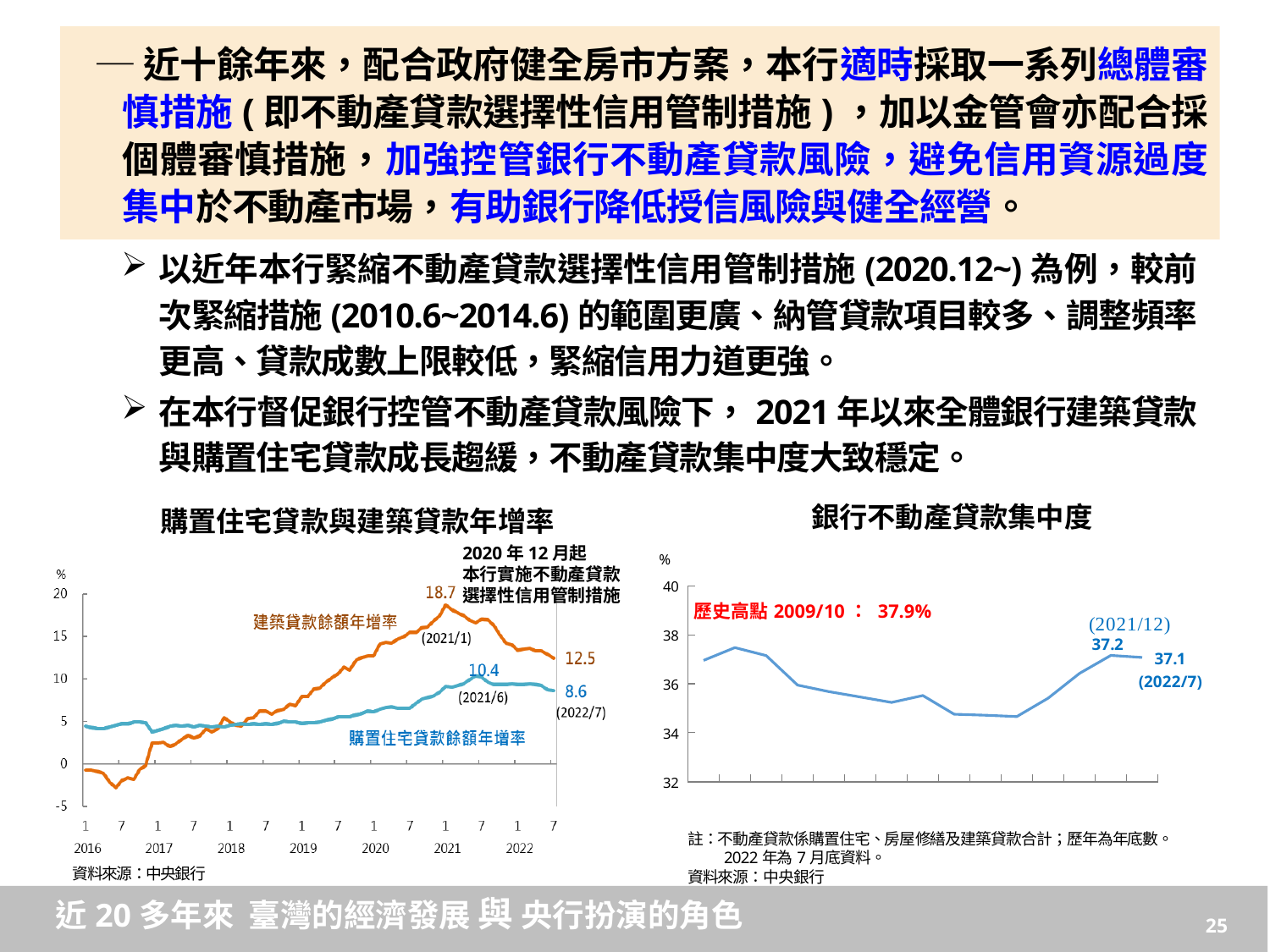
In the chart titled 購置住宅貸款與建築貸款年增率, what was the value of 建築貸款餘額年增率 in 2021/1? 18.7 In the chart titled 銀行不動產貸款集中度, what is the historical high value noted on the chart and when did it occur? 37.9% in 2009/10 In the chart titled 銀行不動產貸款集中度, what was the value in 2022/7? 37.1 In the chart titled 購置住宅貸款與建築貸款年增率, how many series are plotted? 2 In the chart titled 購置住宅貸款與建築貸款年增率, what was the value of 建築貸款餘額年增率 in 2022/7? 12.5 In the chart titled 購置住宅貸款與建築貸款年增率, how much did 建築貸款餘額年增率 fall from its 2021/1 value to its 2022/7 value? 6.2 In the chart titled 銀行不動產貸款集中度, is the value for 2022/7 greater or less than 36? greater In the chart titled 購置住宅貸款與建築貸款年增率, what was the value of 購置住宅貸款餘額年增率 in 2022/7? 8.6 What kind of chart is the one titled 購置住宅貸款與建築貸款年增率? line chart In the chart titled 銀行不動產貸款集中度, what was the value in 2021/12? 37.2 In the chart titled 購置住宅貸款與建築貸款年增率, what was the value of 購置住宅貸款餘額年增率 in 2021/6? 10.4 In the chart titled 購置住宅貸款與建築貸款年增率, which series had the higher value in 2022/7, 建築貸款餘額年增率 or 購置住宅貸款餘額年增率? 建築貸款餘額年增率